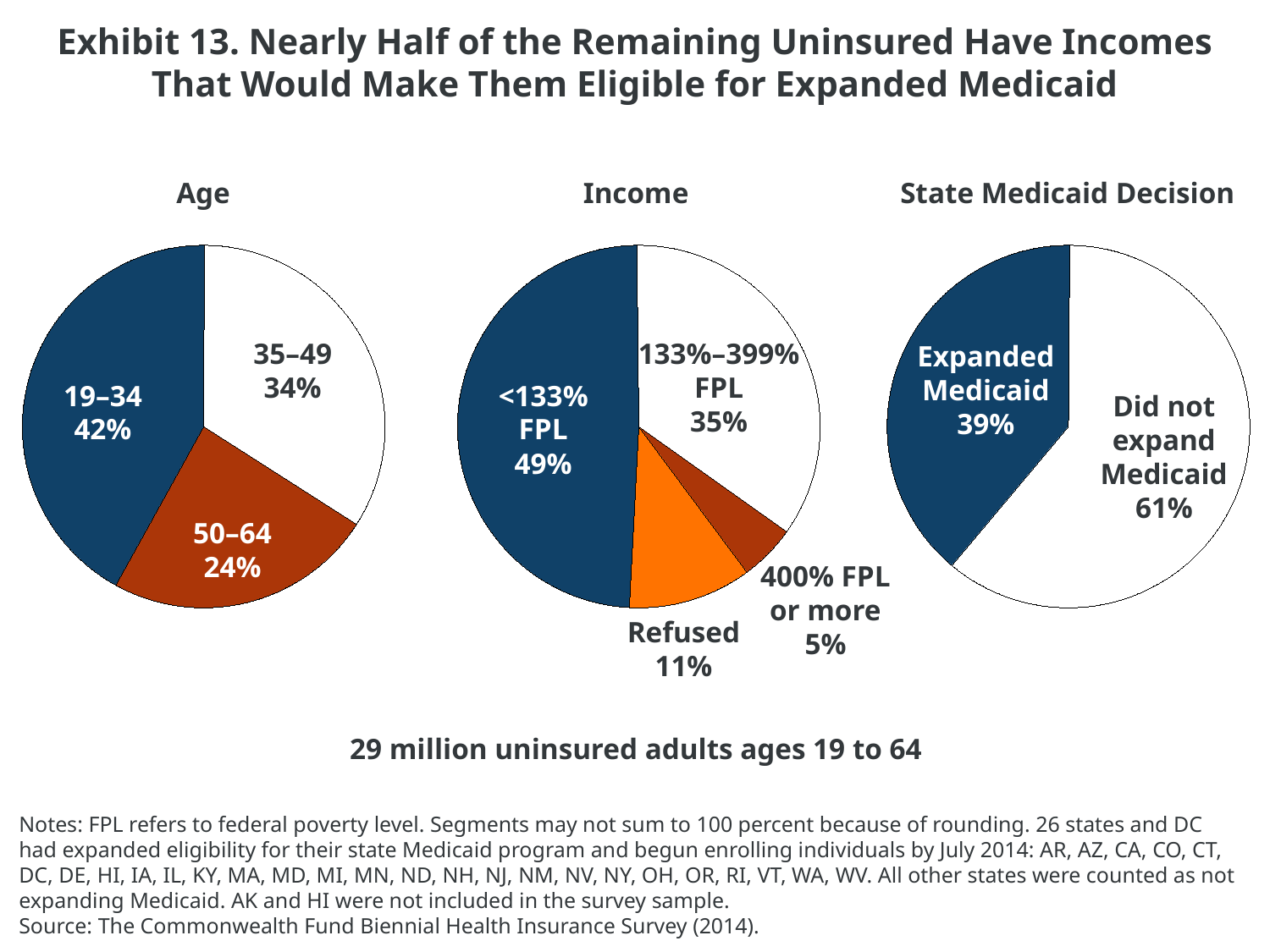
In the Age pie chart, what is the difference between the 19–34 share and the 35–49 share? 8 percentage points In the Age pie chart, what share of uninsured adults are ages 19–34? 42% In the Income pie chart, which income category has the largest share? <133% FPL In the State Medicaid Decision pie chart, which is larger: Expanded Medicaid or Did not expand Medicaid? Did not expand Medicaid In the Age pie chart, which age group has the smallest share? 50–64 How many pie charts are shown on the slide? 3 In the Income pie chart, which category has the smallest share? 400% FPL or more What type of chart is used for the Age, Income, and State Medicaid Decision breakdowns? Pie chart In the Income pie chart, what share of respondents refused to give their income? 11% In the Income pie chart, how many slices are there? 4 In the Income pie chart, what share of uninsured adults have incomes below 133% FPL? 49% In the State Medicaid Decision pie chart, what share of uninsured adults live in states that did not expand Medicaid? 61%